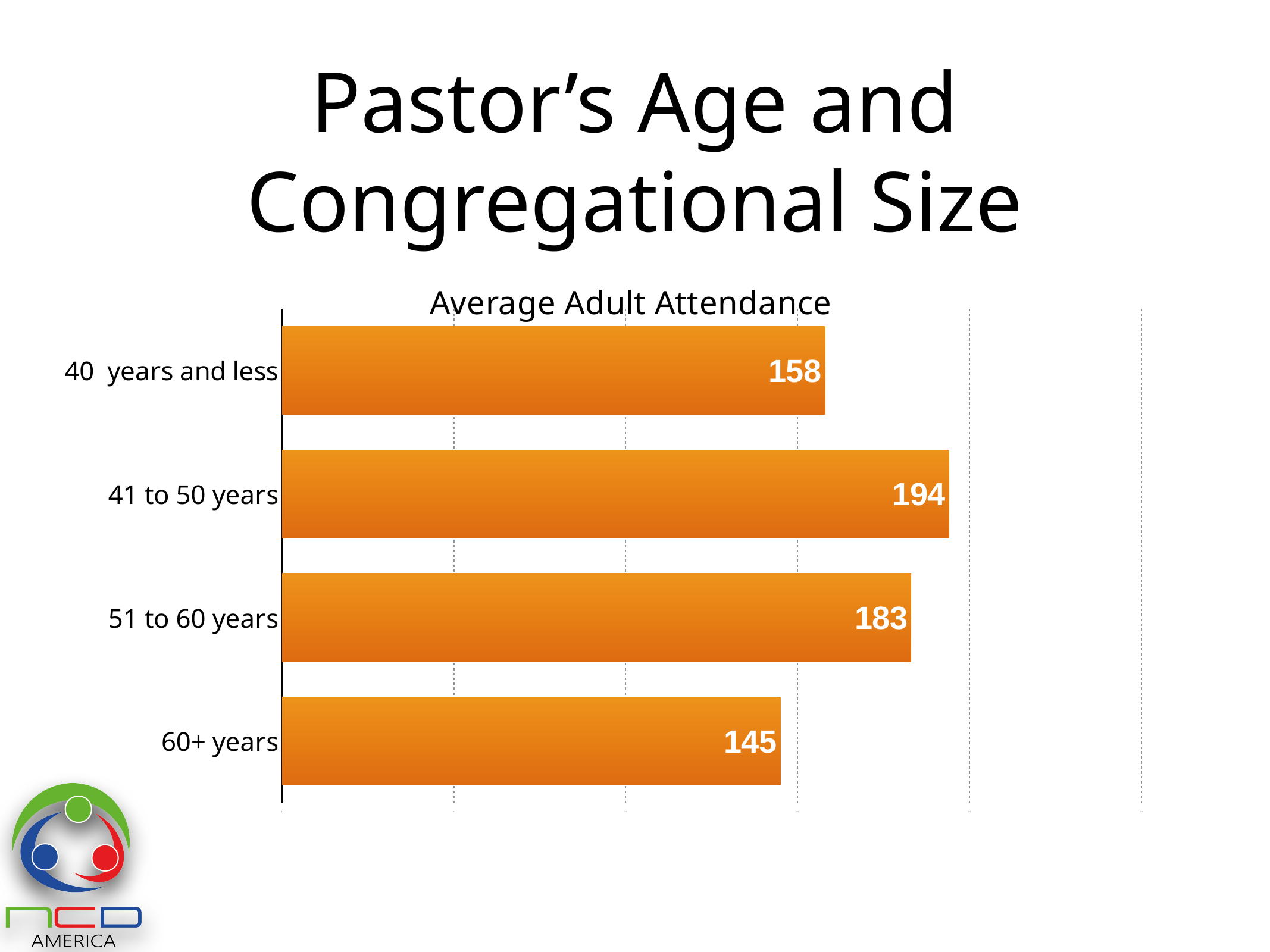
What kind of chart is shown on the slide? Bar chart What is the average adult attendance for pastors aged 51 to 60 years? 183 What is the difference in average adult attendance between the 51 to 60 years group and the 40 years and less group? 25 What is the average adult attendance for pastors aged 60+ years? 145 What is the title of the chart? Average Adult Attendance What is the difference in average adult attendance between the 41 to 50 years group and the 60+ years group? 49 Which pastor age group has the lowest average adult attendance? 60+ years Which has a larger average adult attendance: the 40 years and less group or the 51 to 60 years group? 51 to 60 years Which pastor age group has the highest average adult attendance? 41 to 50 years What is the average adult attendance for pastors aged 40 years and less? 158 How many pastor age groups are shown in the chart? 4 What is the average adult attendance for pastors aged 41 to 50 years? 194